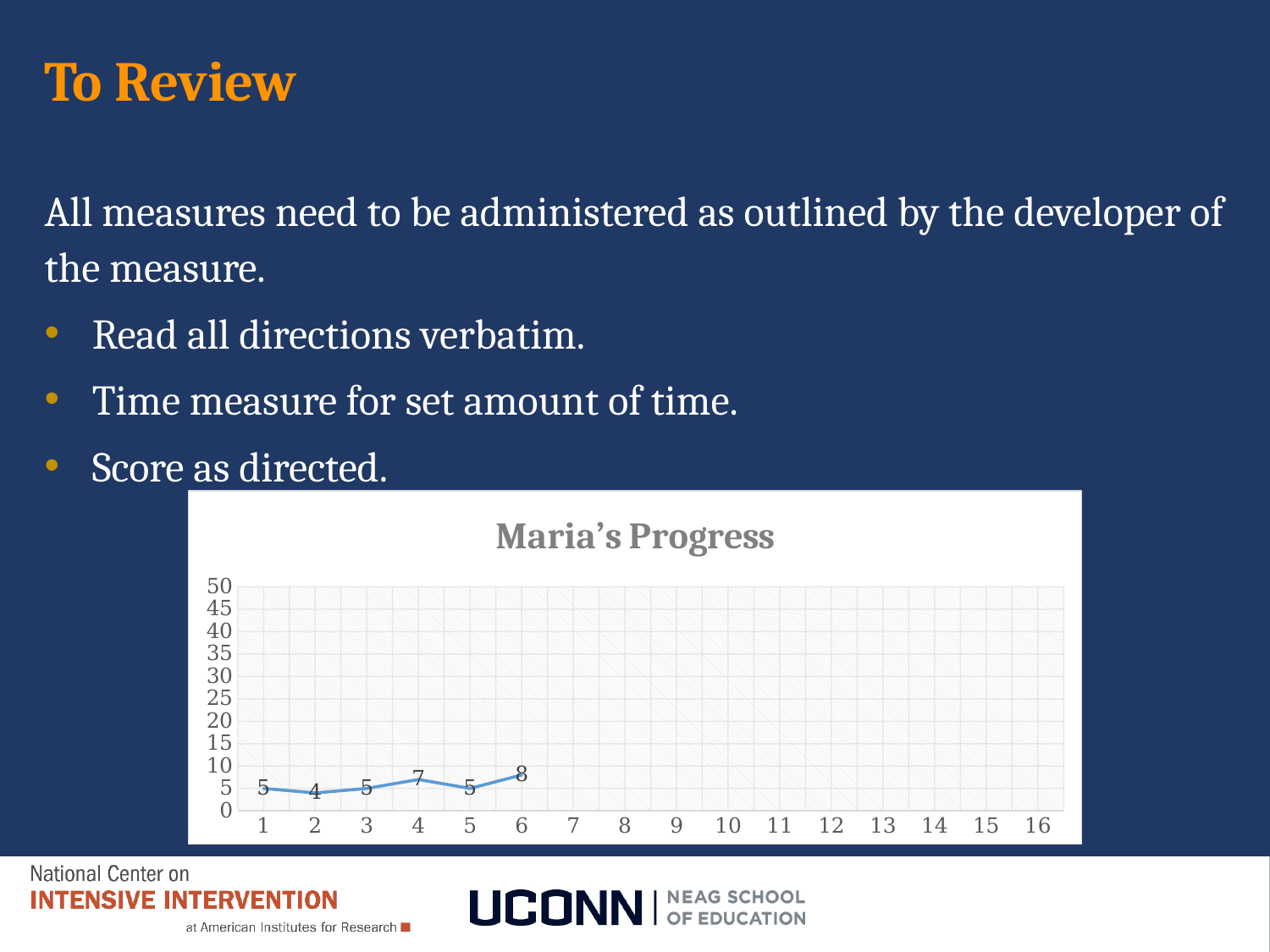
What is the value plotted at point 2 in Maria's Progress? 4 What kind of chart is shown on the slide? line chart Which is larger in Maria's Progress, the value at point 4 or the value at point 5? point 4 What is the value plotted at point 6 in Maria's Progress? 8 At which x-axis point is Maria's Progress value highest? 6 What is the value plotted at point 4 in Maria's Progress? 7 How many data points are plotted on the line in Maria's Progress? 6 At which x-axis point is Maria's Progress value lowest? 2 What is the difference between the values at point 6 and point 2 in Maria's Progress? 4 What is the value plotted at point 1 in Maria's Progress? 5 Is the value at point 6 in Maria's Progress greater or less than 10? less What is the title of the chart? Maria's Progress